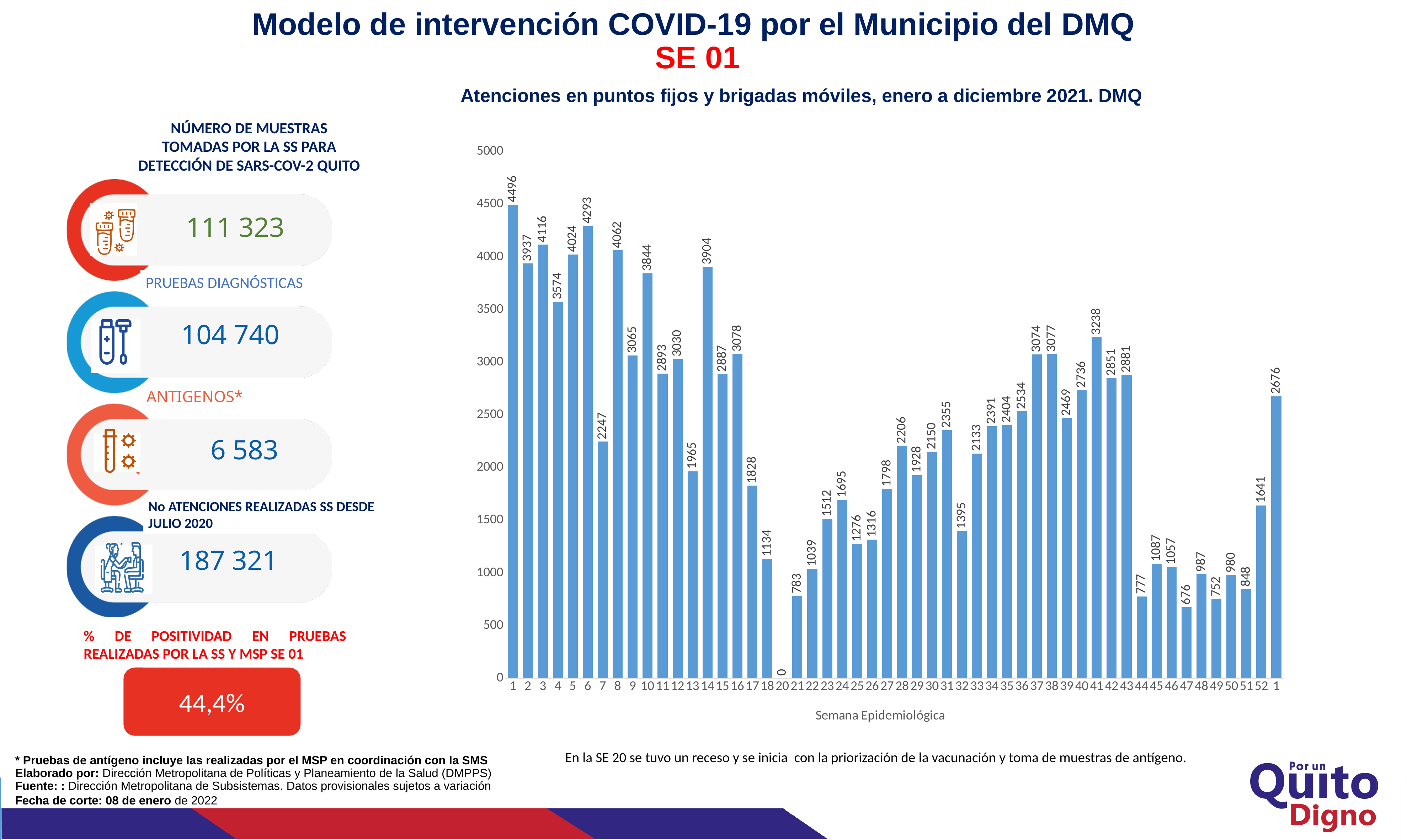
What kind of chart is shown on the slide? Bar chart Which epidemiological week has the highest value in the chart? 1 Is the value for week 44 greater or less than 1000? less What is the difference between the values for week 1 (4496) and week 2 (3937)? 559 What is the value for epidemiological week 41? 3238 What is the value for epidemiological week 47? 676 What is the value for epidemiological week 14 in the chart 'Atenciones en puntos fijos y brigadas móviles'? 3904 Which has a larger value, week 6 or week 7? Week 6 What is the title of the x axis of the chart? Semana Epidemiológica What is the difference between the values for week 52 and week 51? 793 Do the values rise or fall from week 21 to week 24? Rise Which epidemiological week has the lowest value in the chart? 20